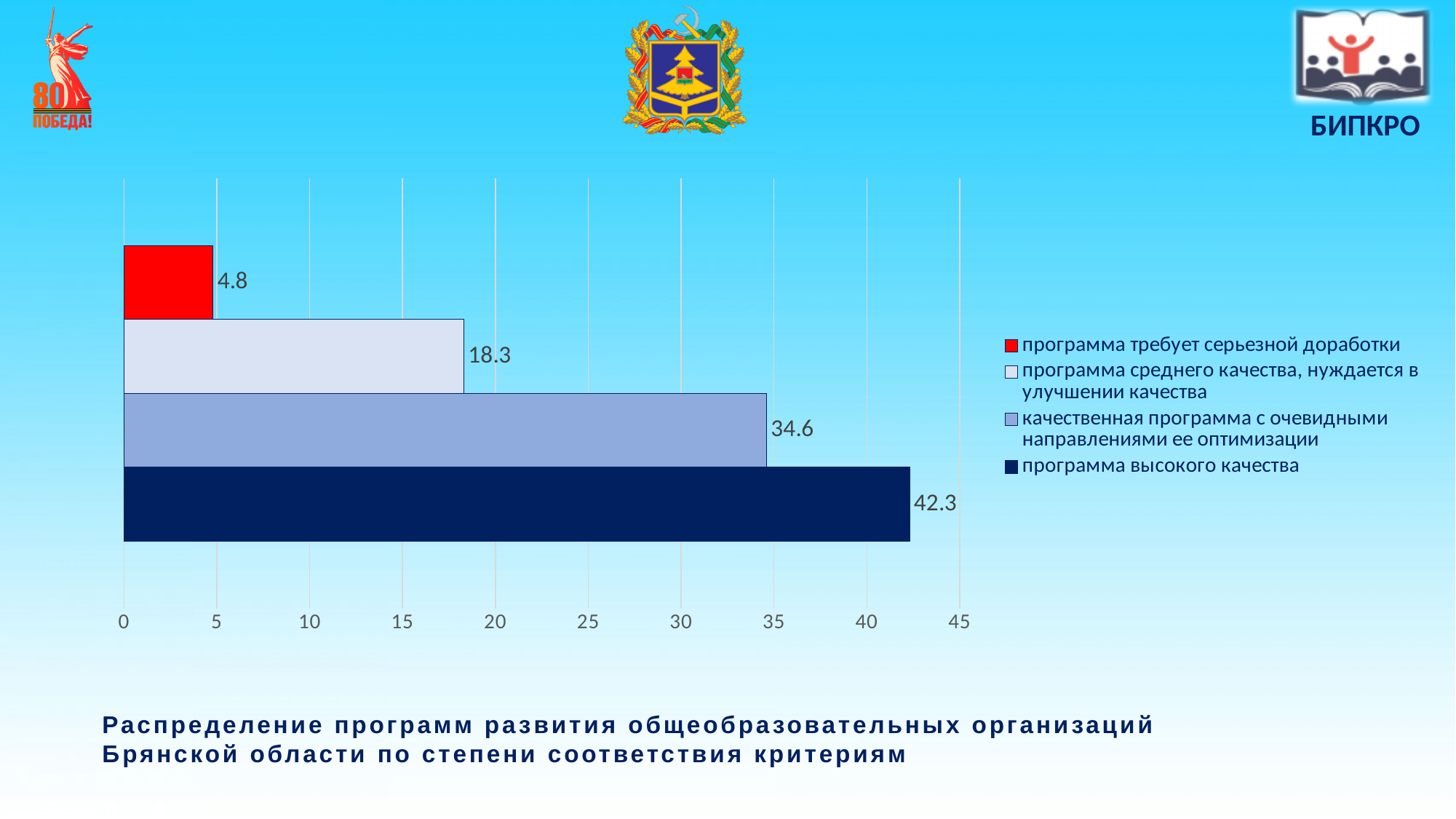
Which category has the highest value? программа высокого качества How many bars are plotted in the chart? 4 What is the value for "программа высокого качества"? 42.3 Is the value for "качественная программа с очевидными направлениями ее оптимизации" greater or less than 30? greater What is the difference between the values for "программа высокого качества" and "качественная программа с очевидными направлениями ее оптимизации"? 7.7 What is the value for "качественная программа с очевидными направлениями ее оптимизации"? 34.6 How many entries does the legend list? 4 Which category has the lowest value? программа требует серьезной доработки What is the value for "программа требует серьезной доработки"? 4.8 Which is larger: the value for "программа среднего качества, нуждается в улучшении качества" or the value for "программа требует серьезной доработки"? программа среднего качества, нуждается в улучшении качества What is the value for "программа среднего качества, нуждается в улучшении качества"? 18.3 What kind of chart is shown on the slide? bar chart